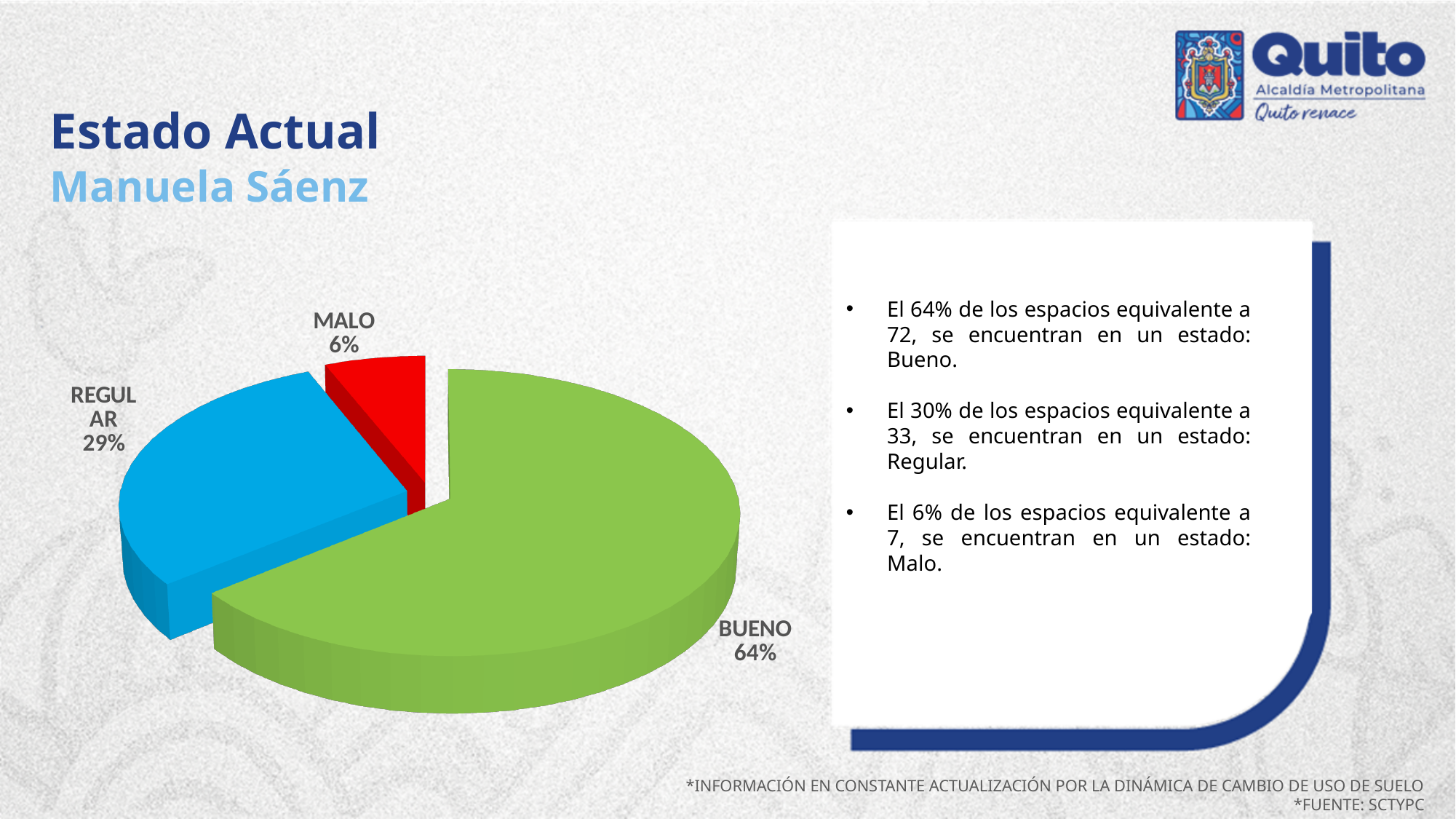
What colour is the MALO slice of the pie? Red What colour is the BUENO slice of the pie? Green What percentage of the pie is labelled MALO? 6% What percentage of the pie is labelled REGULAR? 29% What is the difference in percentage points between the REGULAR and MALO slices? 23 Which category has the smallest slice of the pie? MALO What is the difference in percentage points between the BUENO and REGULAR slices? 35 Which slice is larger, REGULAR or MALO? REGULAR What percentage of the pie is labelled BUENO? 64% How many slices does the pie chart have? 3 What type of chart is shown on the slide? Pie chart Which category has the largest slice of the pie? BUENO